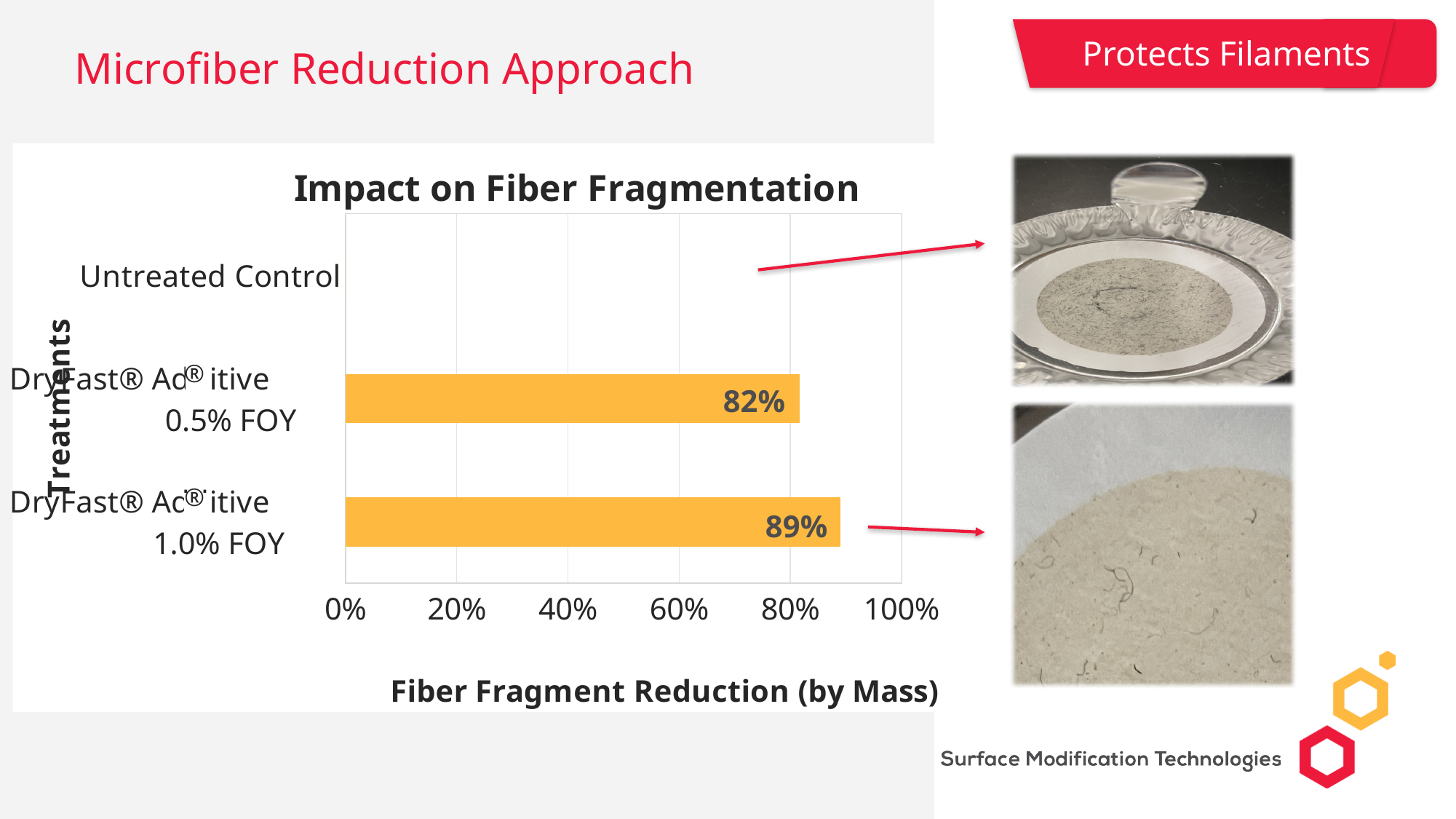
Is the value for DryFast® Additive 0.5% FOY greater or less than 60%? greater Which of the two DryFast® Additive treatments has the lower Fiber Fragment Reduction? DryFast® Additive 0.5% FOY What kind of chart is shown on the slide? bar chart Is the value for DryFast® Additive 1.0% FOY greater or less than 100%? less How many treatment categories are shown on the chart? 3 Which treatment shows the highest Fiber Fragment Reduction? DryFast® Additive 1.0% FOY Which has a larger Fiber Fragment Reduction: DryFast® Additive 0.5% FOY or DryFast® Additive 1.0% FOY? DryFast® Additive 1.0% FOY What is the difference in Fiber Fragment Reduction between DryFast® Additive 1.0% FOY and DryFast® Additive 0.5% FOY? 7% What is the label of the horizontal axis of the chart? Fiber Fragment Reduction (by Mass) What is the Fiber Fragment Reduction value for DryFast® Additive 0.5% FOY? 82% What is the Fiber Fragment Reduction value for DryFast® Additive 1.0% FOY? 89% What is the title of the chart? Impact on Fiber Fragmentation